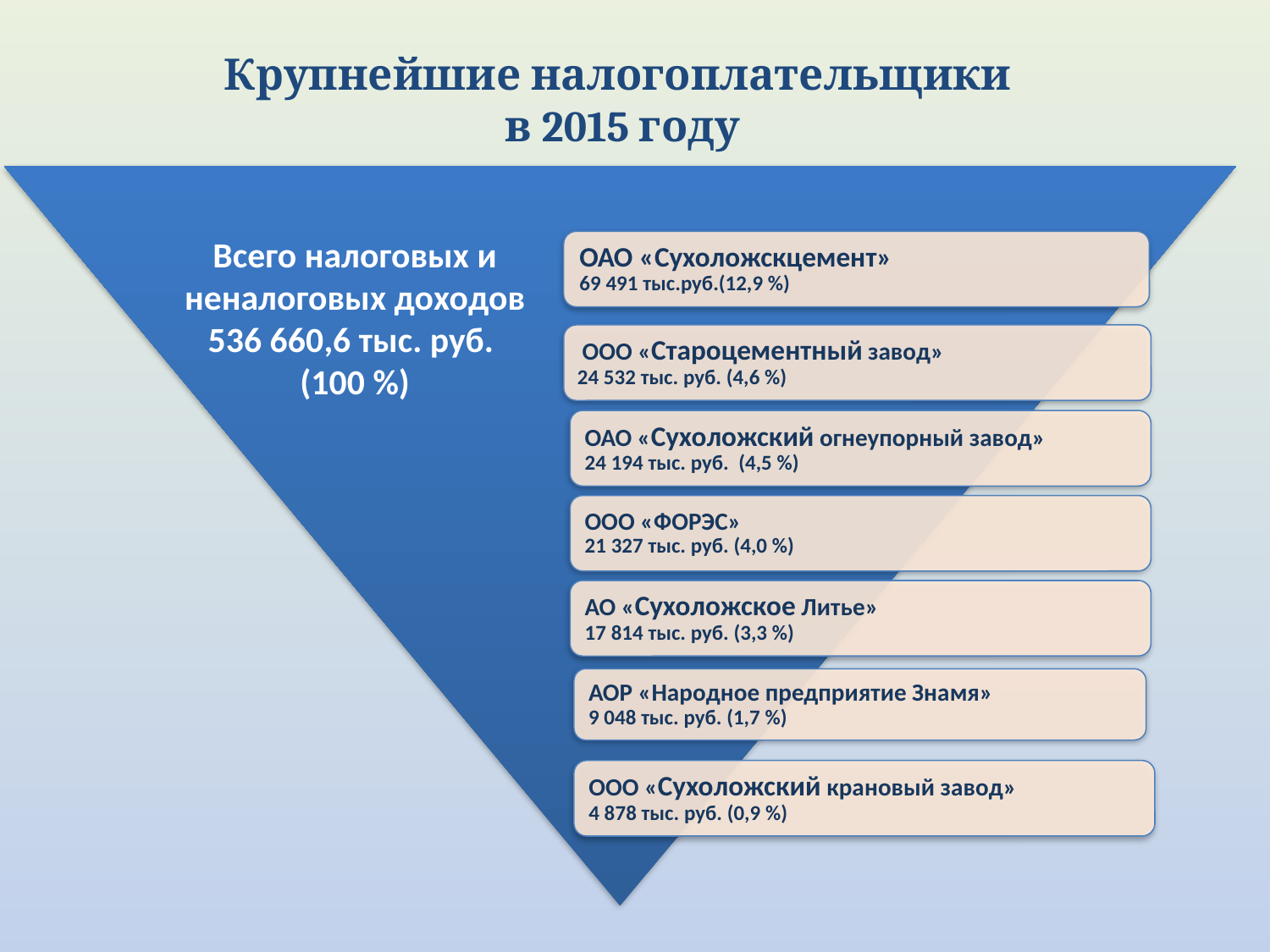
Which paid more: ООО «Староцементный завод» or ОАО «Сухоложский огнеупорный завод»? ООО «Староцементный завод» What is the total of tax and non-tax revenues shown on the slide? 536 660,6 тыс. руб. What share of total revenues is attributed to ООО «ФОРЭС»? 4,0 % Which taxpayer has the largest amount on the slide? ОАО «Сухоложскцемент» What is the difference in тыс. руб. between ОАО «Сухоложскцемент» and ООО «Староцементный завод»? 44 959 Do the amounts increase or decrease going from the top entry to the bottom entry? decrease Which taxpayer has the smallest amount on the slide? ООО «Сухоложский крановый завод» How much did ОАО «Сухоложскцемент» pay according to the slide? 69 491 тыс.руб. What year does the slide title refer to? 2015 What share of total revenues does АО «Сухоложское Литье» account for? 3,3 % What amount is shown for АОР «Народное предприятие Знамя»? 9 048 тыс. руб. How many taxpayers are listed on the slide? 7